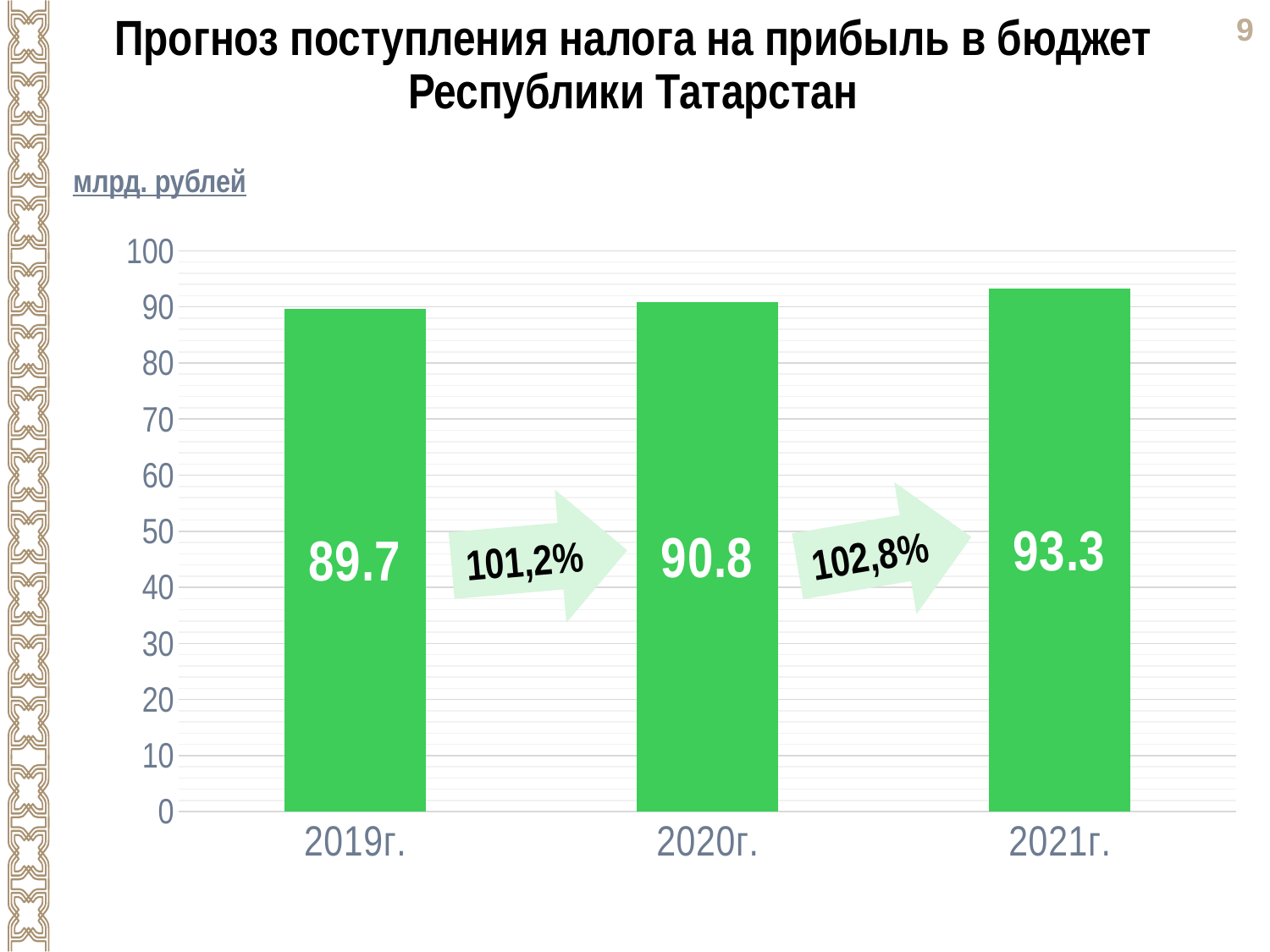
Do the values rise or fall from 2019г. to 2021г.? rise What kind of chart is shown on the slide? bar chart What is the forecast value for 2020г.? 90.8 What is the difference between the values for 2020г. and 2019г.? 1.1 Which year has the highest forecast value? 2021г. What is the forecast value for 2021г.? 93.3 How many years are shown on the chart? 3 Is the value for 2021г. greater or less than 90? greater Which is larger, the value for 2020г. or the value for 2021г.? 2021г. What is the difference between the values for 2021г. and 2019г.? 3.6 What is the forecast value for 2019г.? 89.7 Which year has the lowest forecast value? 2019г.